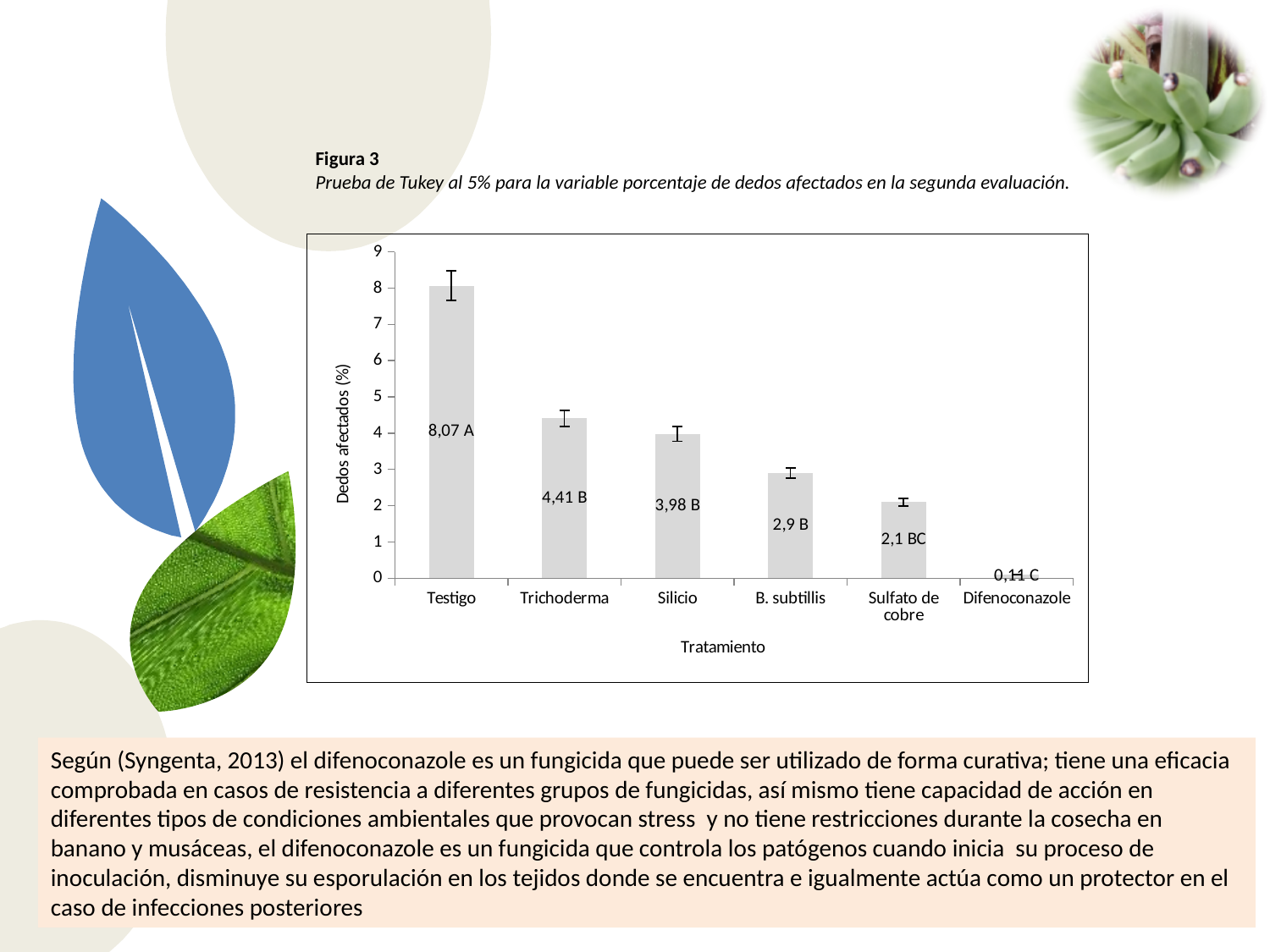
What is the value for Sulfato de cobre? 2,1 What is the value for Trichoderma? 4,41 What is the value for Testigo? 8,07 Which treatment has the highest percentage of affected fingers? Testigo What is the difference between the values for Testigo and Trichoderma? 3,66 What type of chart is shown on the slide? bar chart What is the value for Difenoconazole? 0,11 Which treatment has the lowest percentage of affected fingers? Difenoconazole Which is larger, the value for Silicio or the value for B. subtillis? Silicio Do the values rise or fall from left to right along the x axis? fall What is the difference between the values for B. subtillis and Sulfato de cobre? 0,8 How many treatments are shown on the x axis? 6